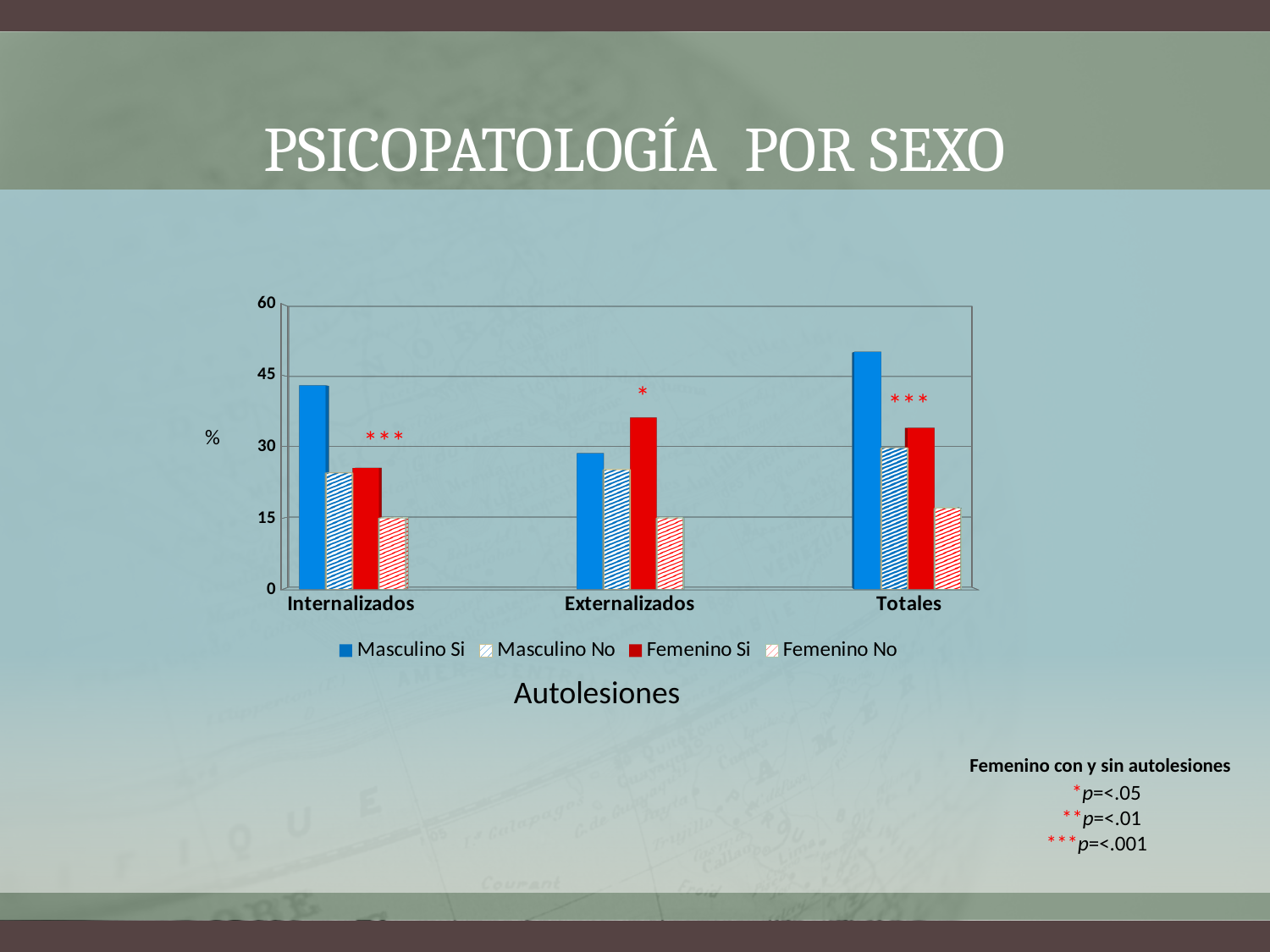
Is the value for Masculino Si in the Internalizados category greater or less than 30? greater In which category is the Masculino Si value the highest? Totales Is the value for Masculino Si in the Totales category greater or less than 45? greater Is the value for Femenino Si in the Externalizados category greater or less than 30? greater In the Internalizados category, which is larger: Masculino Si or Femenino Si? Masculino Si What kind of chart is shown on the slide? bar chart In the Externalizados category, which is larger: Femenino Si or Masculino Si? Femenino Si What is the title shown below the chart's legend? Autolesiones How many series does the chart legend list? 4 Which series has the lowest value in the Totales category? Femenino No Which series has the highest value in the Totales category? Masculino Si How many categories are shown on the x axis of the chart? 3